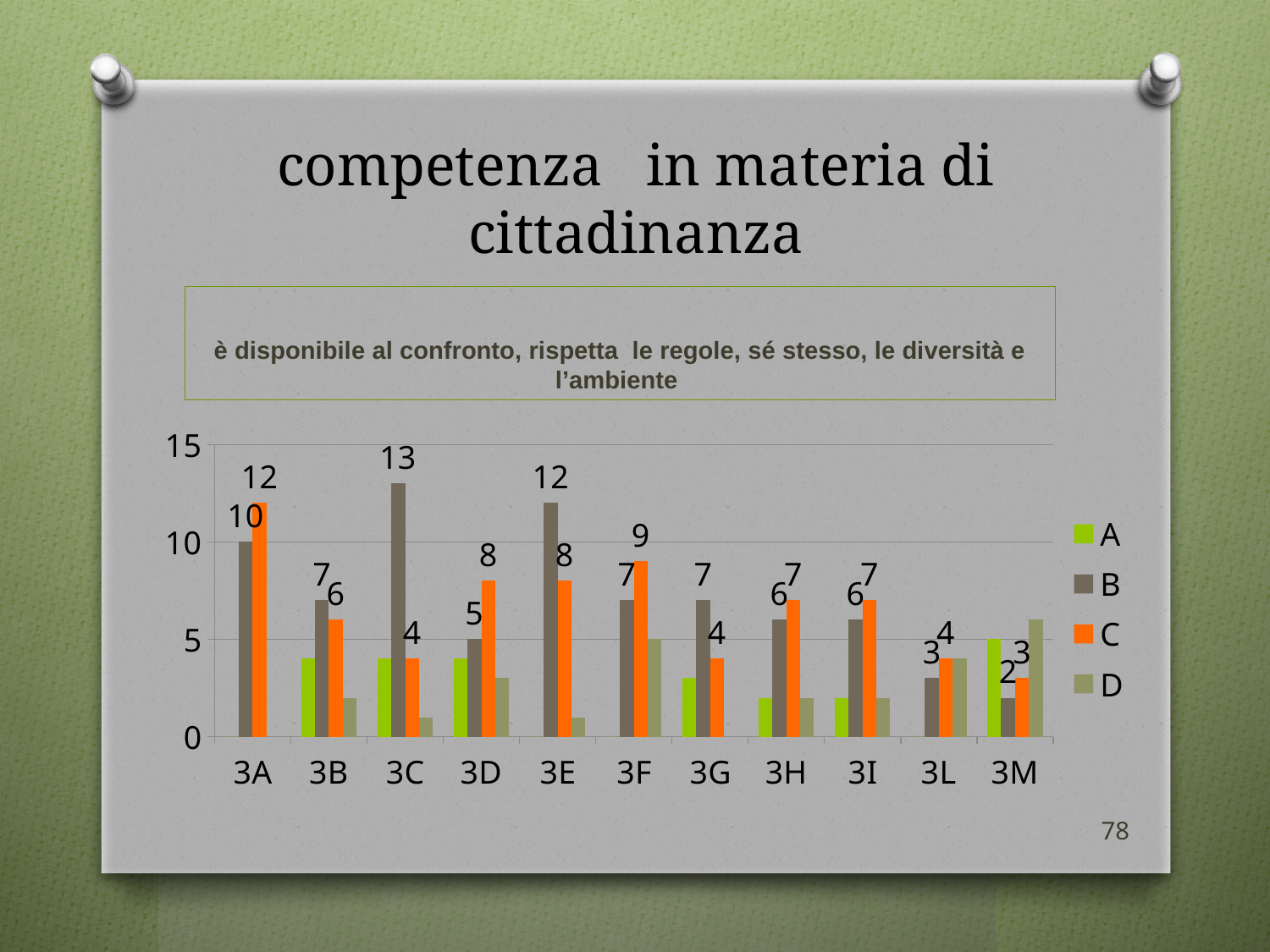
For class 3F, which is larger: series B or series C? C Which class has the lowest value for series B? 3M What is the value of series B for class 3C? 13 What is the value of series C for class 3D? 8 How many series does the legend list? 4 Is the value of series A for class 3B greater or less than 5? less Which class has the highest value for series C? 3A What kind of chart is shown on the slide? bar chart What is the value of series C for class 3A? 12 How many classes are shown along the x axis? 11 What is the difference between series C and series B for class 3A? 2 Which class has the highest value for series B? 3C